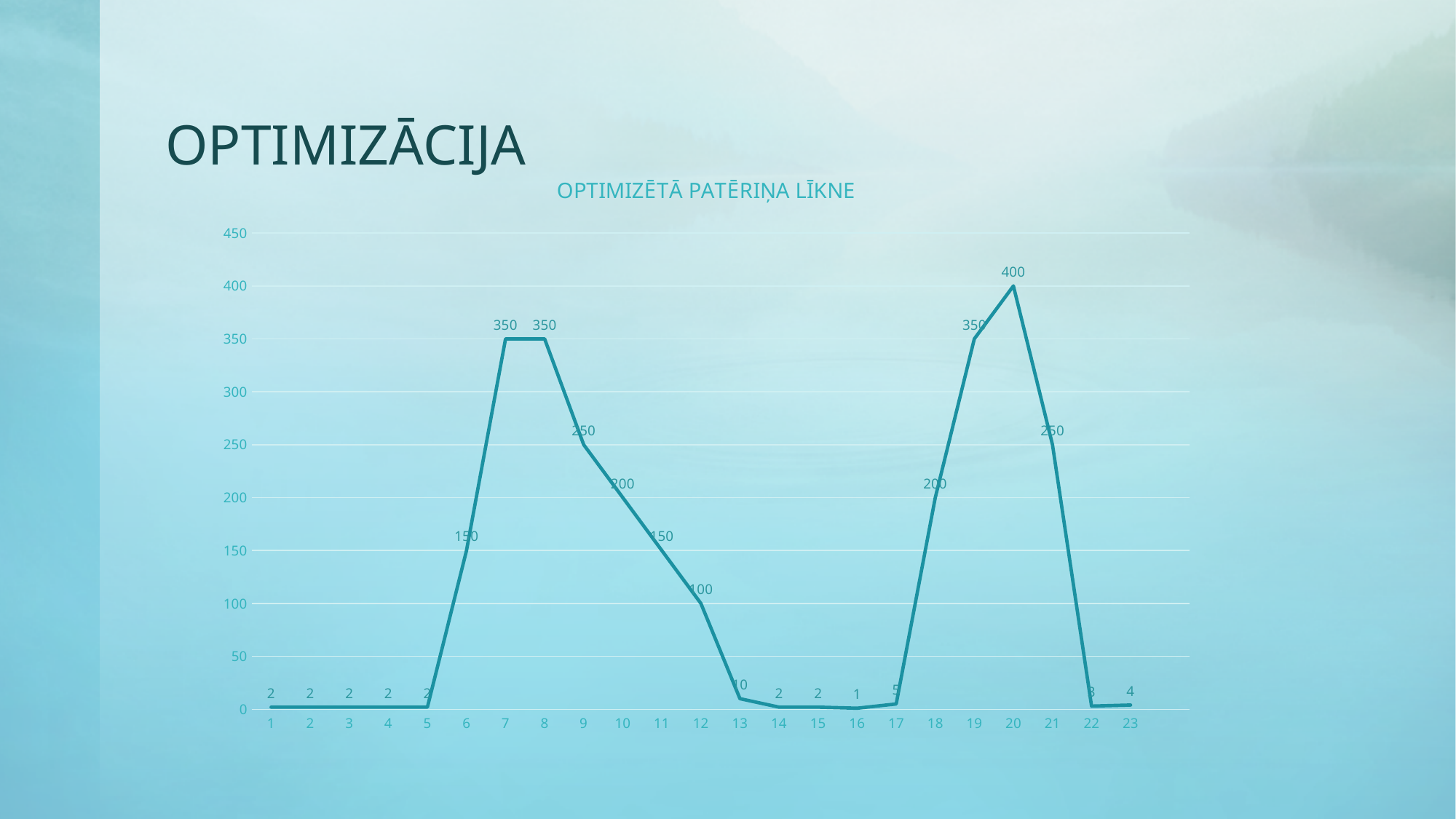
Which point on the x axis has the highest value? 20 What is the value at point 20? 400 Which is larger, the value at point 9 or the value at point 18? point 9 What is the difference between the values at point 20 and point 19? 50 Which point on the x axis has the lowest value? 16 What is the value at point 13? 10 What type of chart is shown on the slide? line chart How many points are plotted along the x axis? 23 What is the title of the chart? OPTIMIZĒTĀ PATĒRIŅA LĪKNE Do the values rise or fall from point 9 to point 12? fall What is the value at point 7? 350 What is the value at point 16? 1